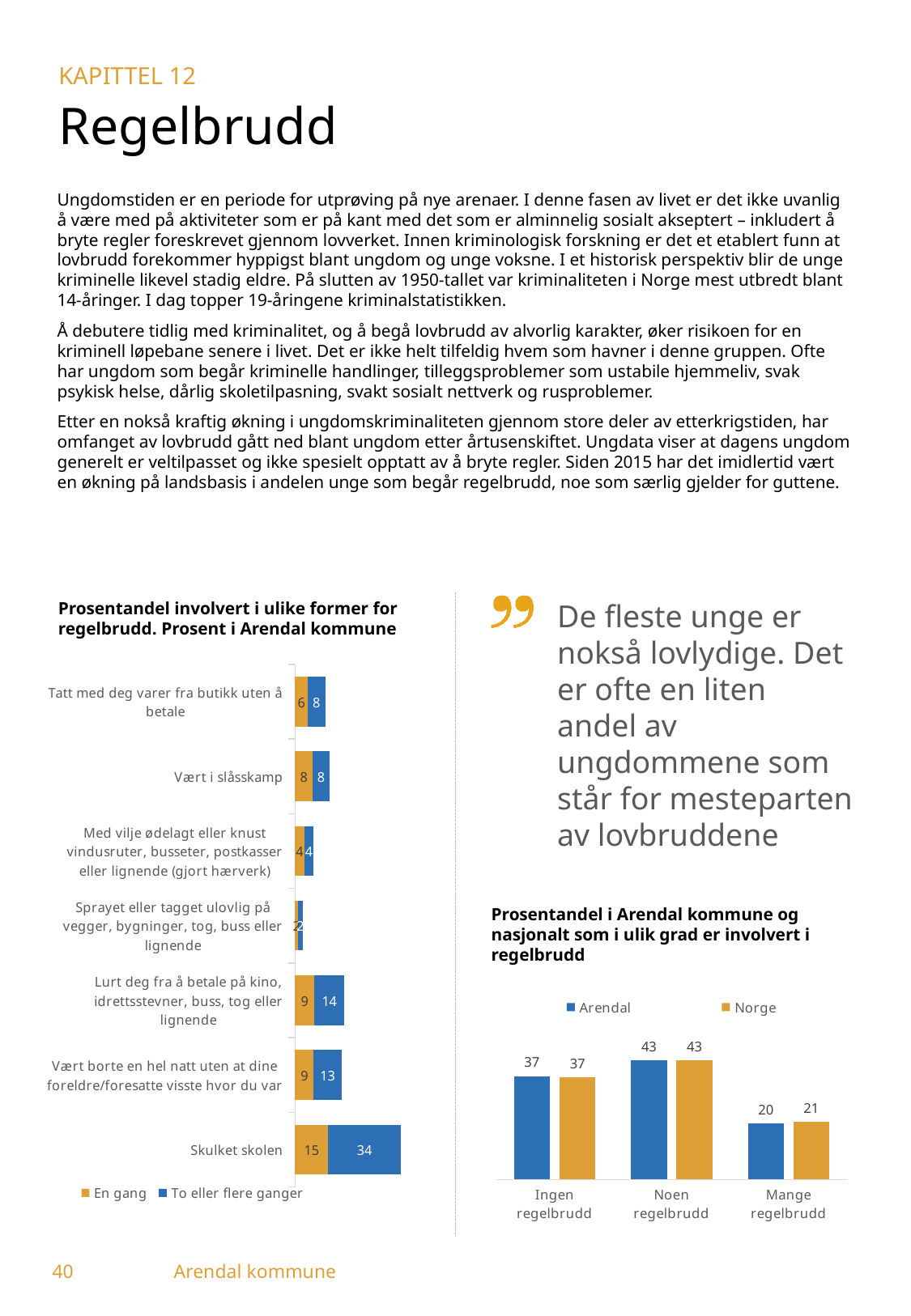
In the chart 'Prosentandel involvert i ulike former for regelbrudd', what is the value for 'En gang' for 'Lurt deg fra å betale på kino, idrettsstevner, buss, tog eller lignende'? 9 In the chart 'Prosentandel involvert i ulike former for regelbrudd', how many series does the legend list? 2 In the chart 'Prosentandel involvert i ulike former for regelbrudd', what is the total of the stacked bar for 'Skulket skolen'? 49 In the chart 'Prosentandel i Arendal kommune og nasjonalt', what is the value for Norge for 'Mange regelbrudd'? 21 In the chart 'Prosentandel i Arendal kommune og nasjonalt', which category has the highest value for Arendal? Noen regelbrudd In the chart 'Prosentandel i Arendal kommune og nasjonalt', what is the difference between Arendal and Norge for 'Mange regelbrudd'? 1 In the chart 'Prosentandel involvert i ulike former for regelbrudd', which category has the highest total? Skulket skolen In the chart 'Prosentandel involvert i ulike former for regelbrudd', what is the total of the stacked bar for 'Vært i slåsskamp'? 16 In the chart 'Prosentandel involvert i ulike former for regelbrudd', what is the value for 'To eller flere ganger' for 'Skulket skolen'? 34 In the chart 'Prosentandel i Arendal kommune og nasjonalt', what kind of chart is it? Bar chart In the chart 'Prosentandel i Arendal kommune og nasjonalt', which colour represents Norge? Orange In the chart 'Prosentandel involvert i ulike former for regelbrudd', how many categories are shown? 7